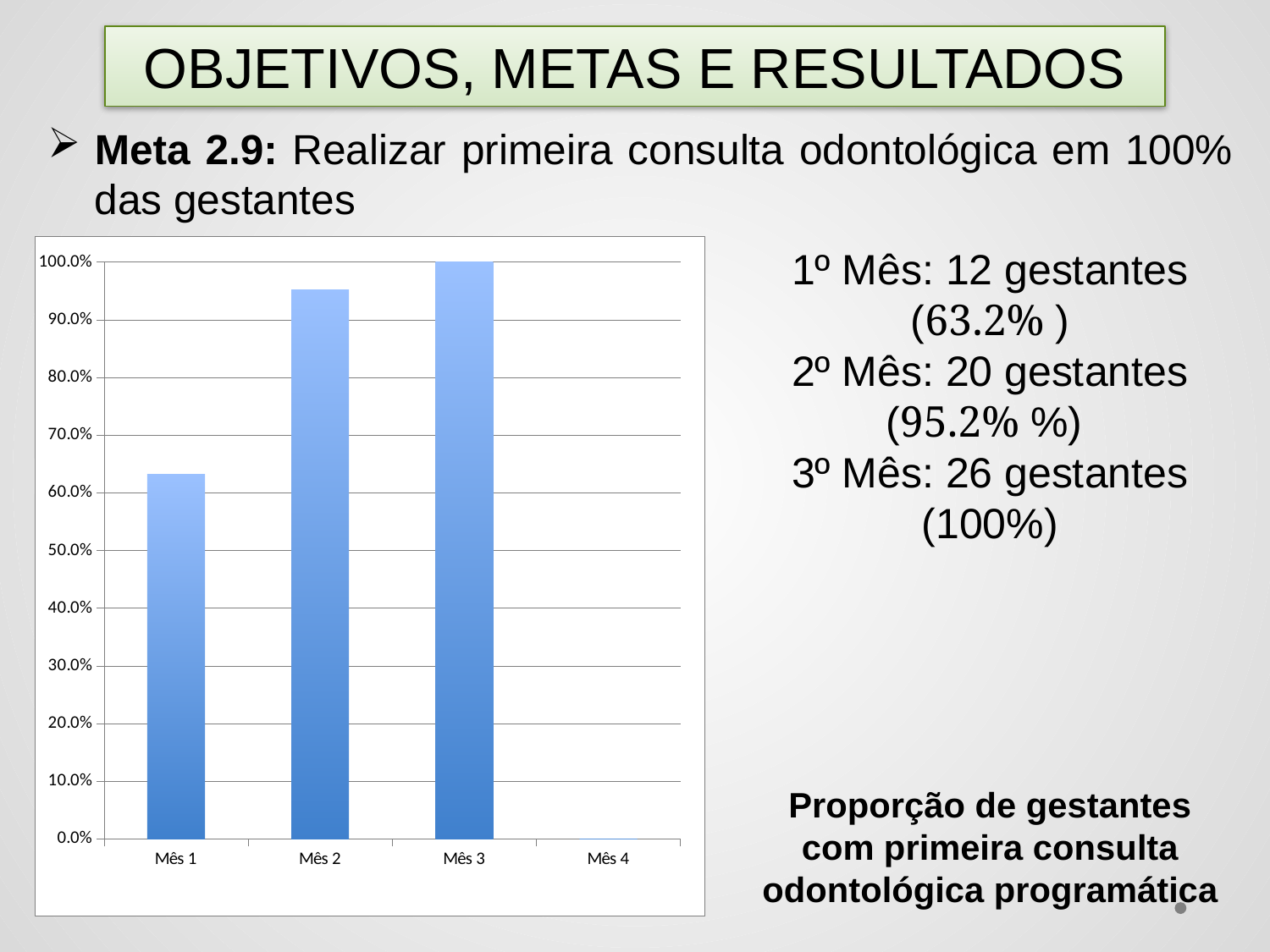
According to the caption next to the chart, what proportion does the chart show? Proporção de gestantes com primeira consulta odontológica programática Is the value for Mês 2 greater or less than 90.0%? greater How many month categories are shown on the x axis of the chart? 4 Which is larger, the value for Mês 1 or the value for Mês 2? Mês 2 Which month category on the x axis has no bar plotted? Mês 4 Do the bar values rise or fall from Mês 1 to Mês 3? rise What is the highest value shown on the y axis of the chart? 100.0% What value does the bar for Mês 3 reach on the y axis? 100.0% Is the value for Mês 1 greater or less than 60.0%? greater Which month has the highest bar in the chart? Mês 3 What kind of chart is shown on the slide? bar chart Is the value for Mês 1 greater or less than 70.0%? less